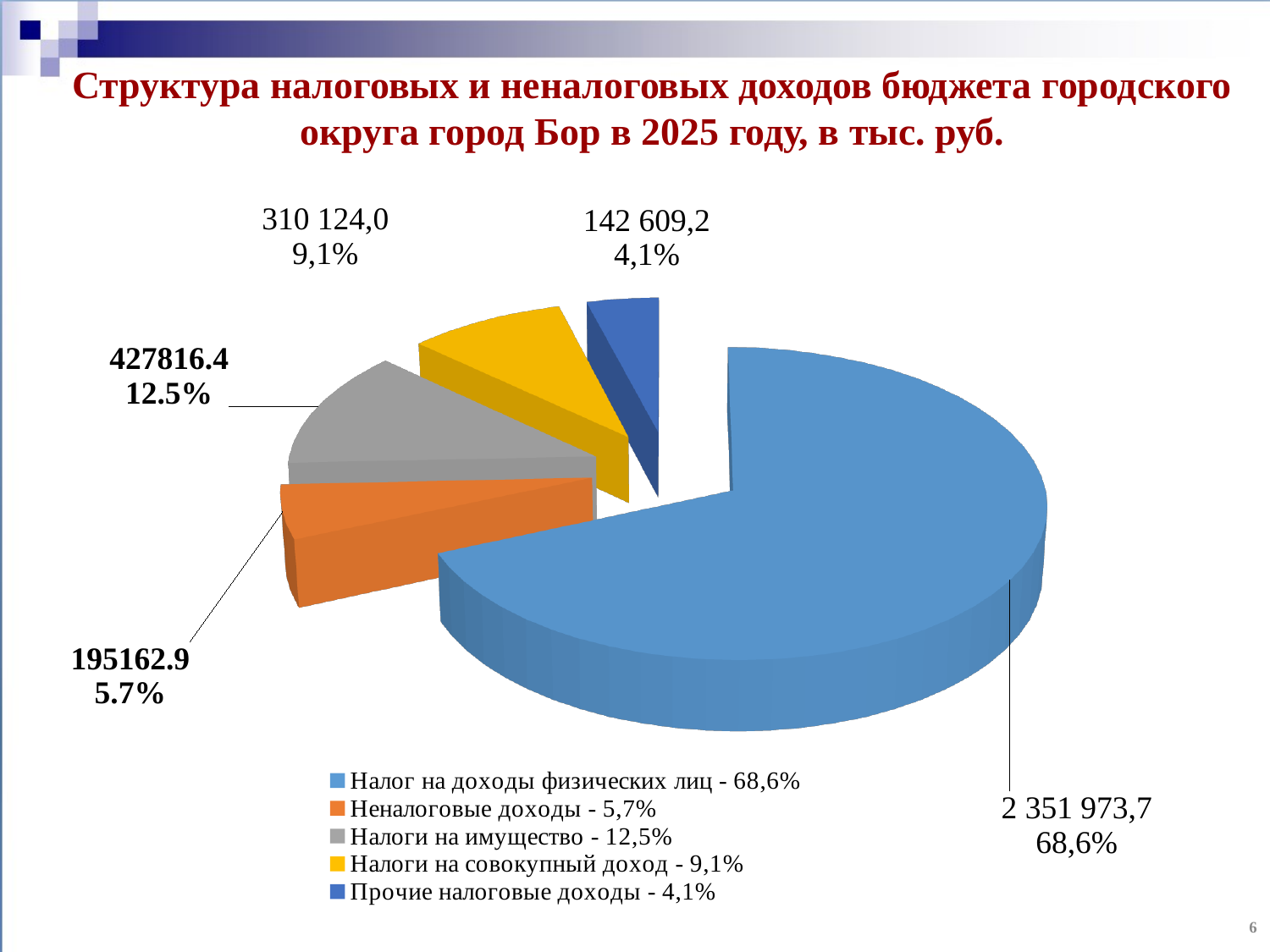
What value is shown for Налоги на совокупный доход? 310 124,0 What kind of chart is shown on the slide? pie chart What value is shown for Налоги на имущество? 427816.4 How many entries does the legend list? 5 How many slices does the pie chart have? 5 Which is larger: Налоги на имущество or Налоги на совокупный доход? Налоги на имущество What value is shown for Прочие налоговые доходы? 142 609,2 Which category has the smallest slice? Прочие налоговые доходы What share of the pie does Налог на доходы физических лиц represent? 68,6% Which category has the largest slice? Налог на доходы физических лиц What share of the pie does Неналоговые доходы represent? 5.7% What value is shown for Налог на доходы физических лиц? 2 351 973,7